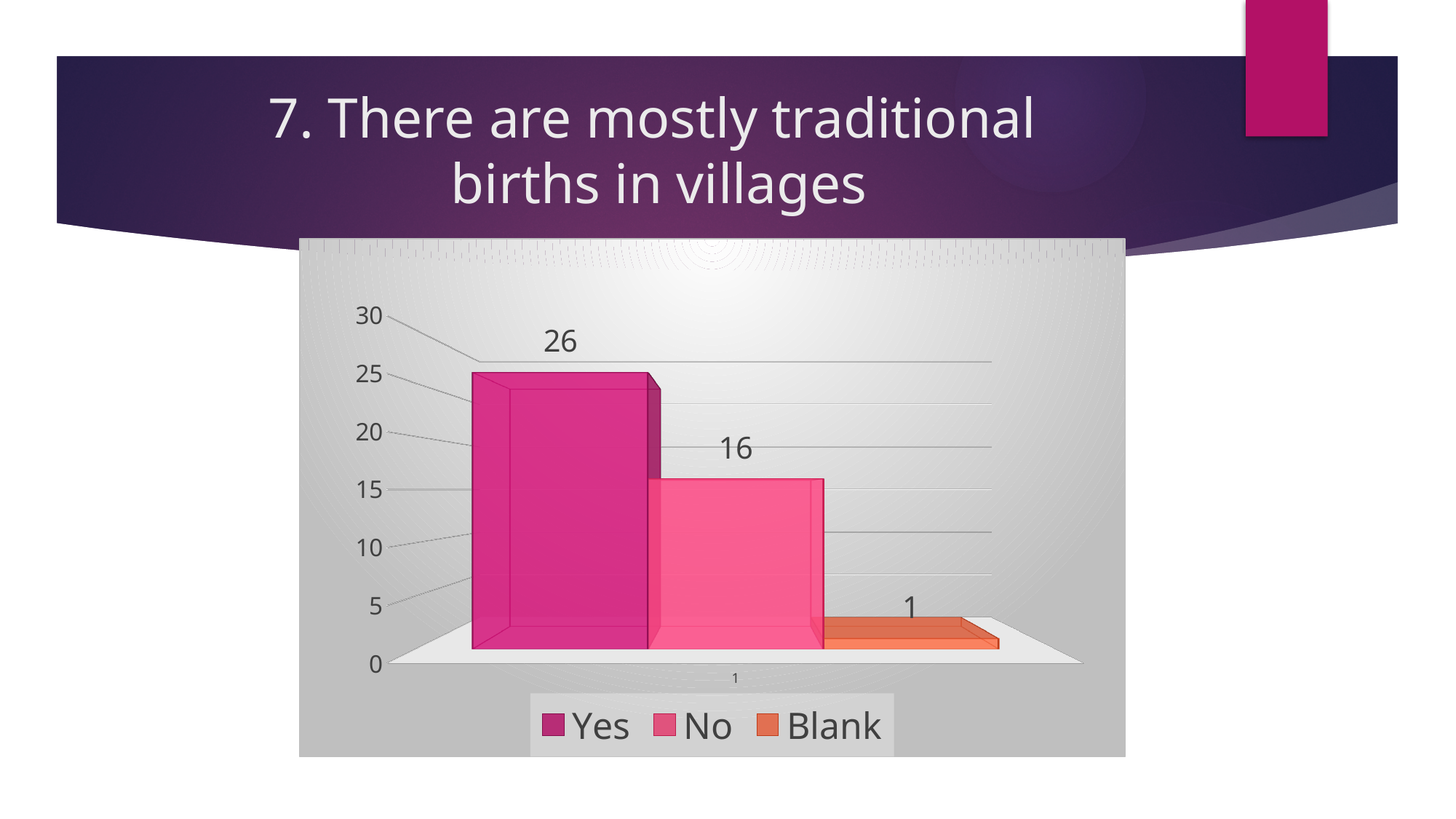
Which series has the highest value? Yes What is the value for Yes? 26 What is the difference between the values for No and Blank? 15 What is the difference between the values for Yes and No? 10 Which is larger, the value for Yes or the value for No? Yes What is the value for Blank? 1 What kind of chart is shown on the slide? bar chart Is the value for No greater or less than 20? less How many series does the legend list? 3 What is the value for No? 16 Which series has the lowest value? Blank What is the title of the slide above the chart? 7. There are mostly traditional births in villages